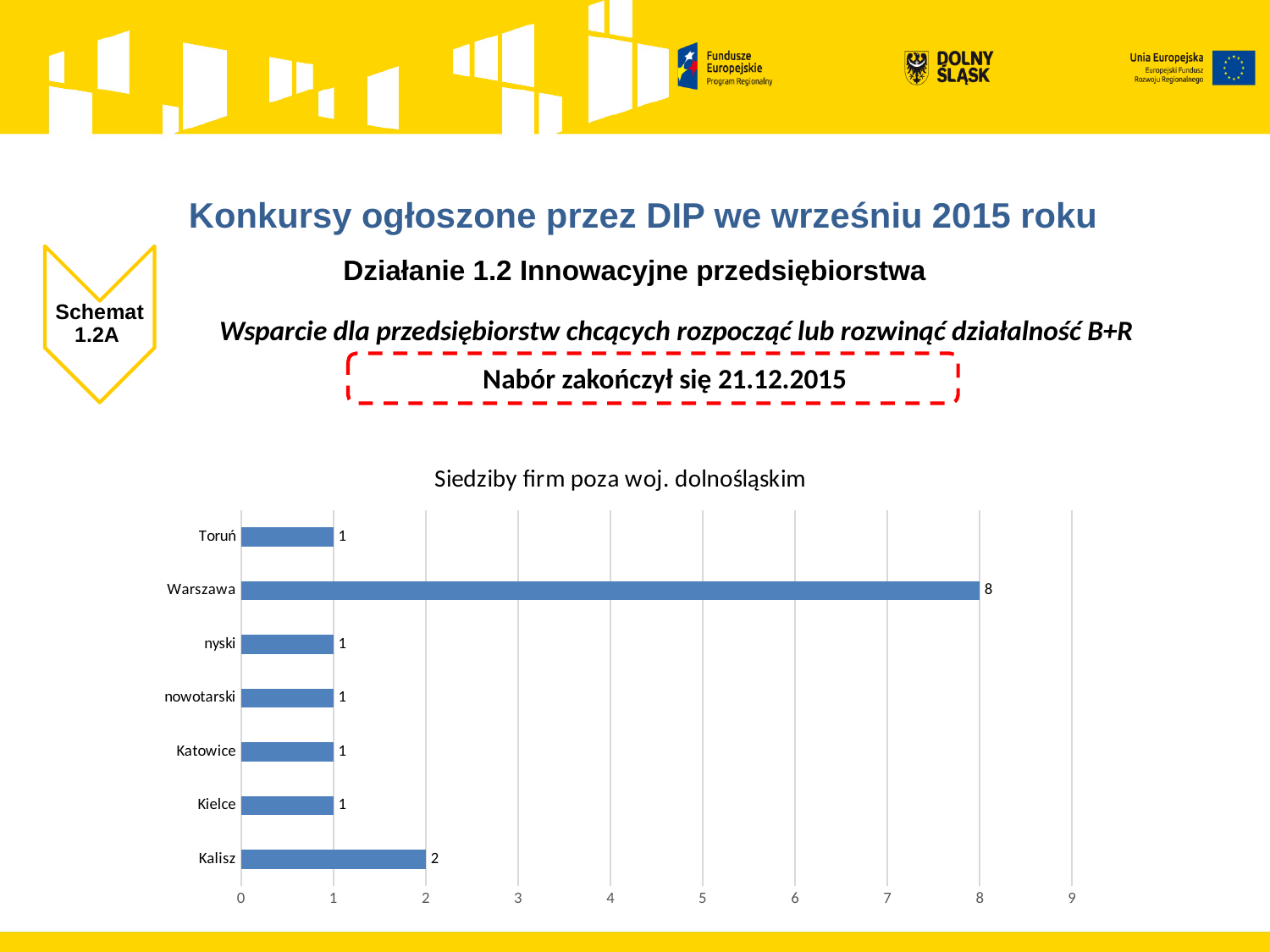
What kind of chart is shown on the slide? bar chart What is the value for Katowice? 1 What is the title of the chart? Siedziby firm poza woj. dolnośląskim How many categories are shown in the chart? 7 What is the value for Warszawa? 8 Which category has the highest value? Warszawa How many categories have a value of 1? 5 Is the value for Warszawa greater or less than 5? greater What is the value for Toruń? 1 What is the value for Kalisz? 2 Which is larger, the value for Kalisz or the value for Kielce? Kalisz What is the difference between the values for Warszawa and Kalisz? 6